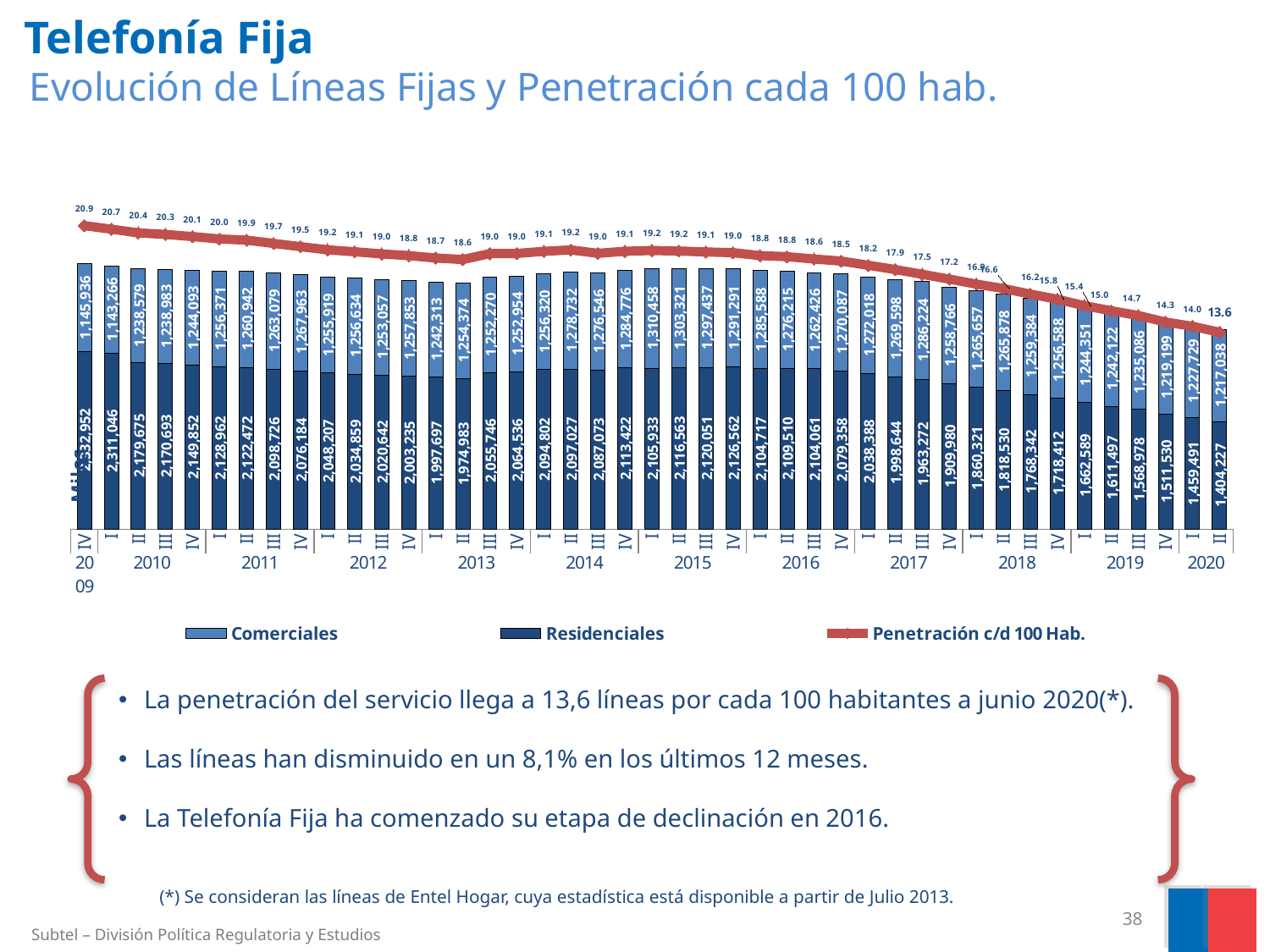
How many series does the legend list? 3 What is the total of the stacked bar for II 2020 (Comerciales plus Residenciales)? 2,621,265 What is the Residenciales value for IV 2009? 2,332,952 What is the difference between the Penetración c/d 100 Hab. value in IV 2009 and in II 2020? 7.3 In which quarter is the Penetración c/d 100 Hab. value highest? IV 2009 How many quarters are plotted on the x axis? 43 What type of chart is shown on the slide? Stacked bar chart with a line What is the Comerciales value for I 2015? 1,310,458 What is the Penetración c/d 100 Hab. value for II 2020? 13.6 Which is larger, the Residenciales value for I 2020 or for II 2020? I 2020 Does the Penetración c/d 100 Hab. line rise or fall from I 2016 to II 2020? Fall In which quarter is the Residenciales value lowest? II 2020